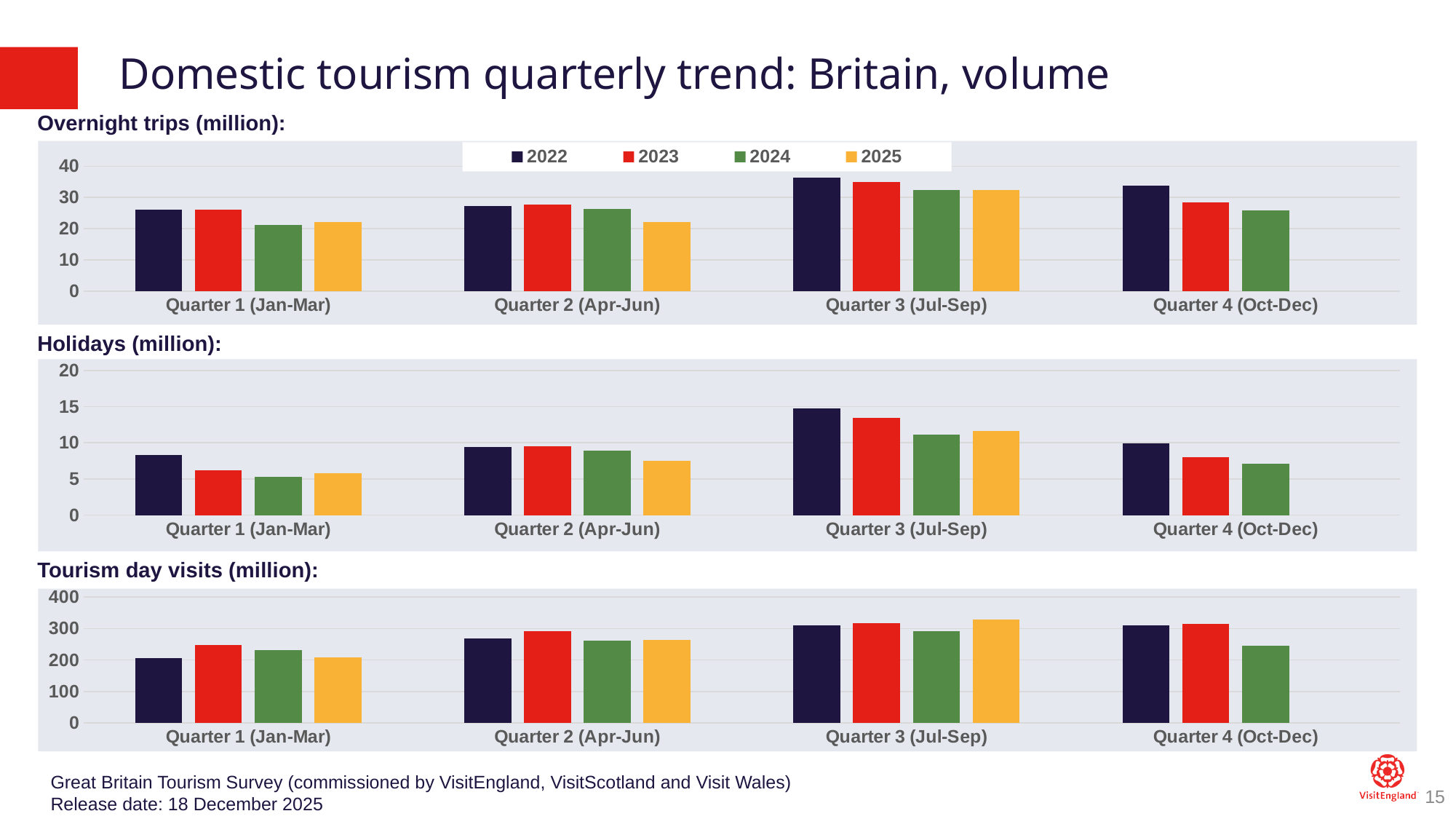
What kind of chart is the Holidays (million) chart? bar chart On the Overnight trips chart, is the value for 2022 in Quarter 3 (Jul-Sep) greater or less than 30? greater How many quarters are shown on the x axis of the Tourism day visits chart? 4 On the Tourism day visits chart, is the value for 2025 in Quarter 3 (Jul-Sep) greater or less than 300? greater On the Tourism day visits chart, is the value for 2024 in Quarter 4 (Oct-Dec) greater or less than 300? less How many series does the legend list on the Overnight trips chart? 4 On the Overnight trips chart, which quarter has no bar for 2025? Quarter 4 (Oct-Dec) On the Holidays chart, which quarter has the highest value for 2022? Quarter 3 (Jul-Sep) On the Tourism day visits chart, in Quarter 1 (Jan-Mar), which is larger: 2022 or 2023? 2023